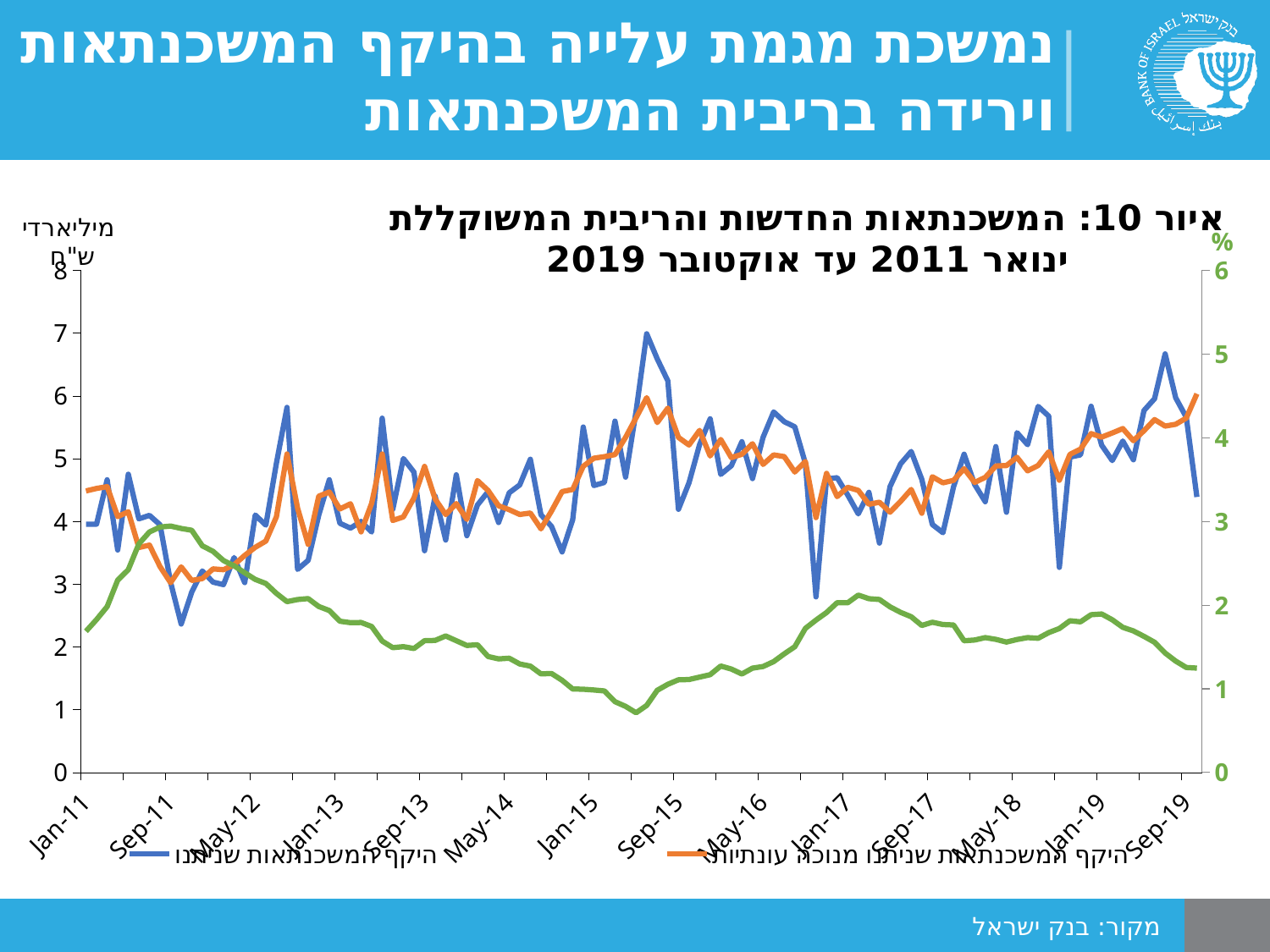
Is the value of the green line at Sep-19 greater or less than 2 on the right axis? less How many date labels are shown along the x axis? 14 Does the orange line (היקף המשכנתאות שניתנו מנוכה עונתיות) generally rise or fall between Jan-17 and Sep-19? rise What kind of chart is shown on the slide? line chart Is the peak of the blue line (היקף המשכנתאות שניתנו) around Sep-15 greater or less than 6 on the left axis? greater Which series is drawn in blue according to the legend? היקף המשכנתאות שניתנו Is the lowest point of the green line, around mid-2015, greater or less than 1 on the right axis? less Does the green line generally rise or fall between Sep-11 and Sep-15? fall What is the figure number given in the chart title? איור 10 How many series does the legend list? 2 What is the highest value shown on the left vertical axis? 8